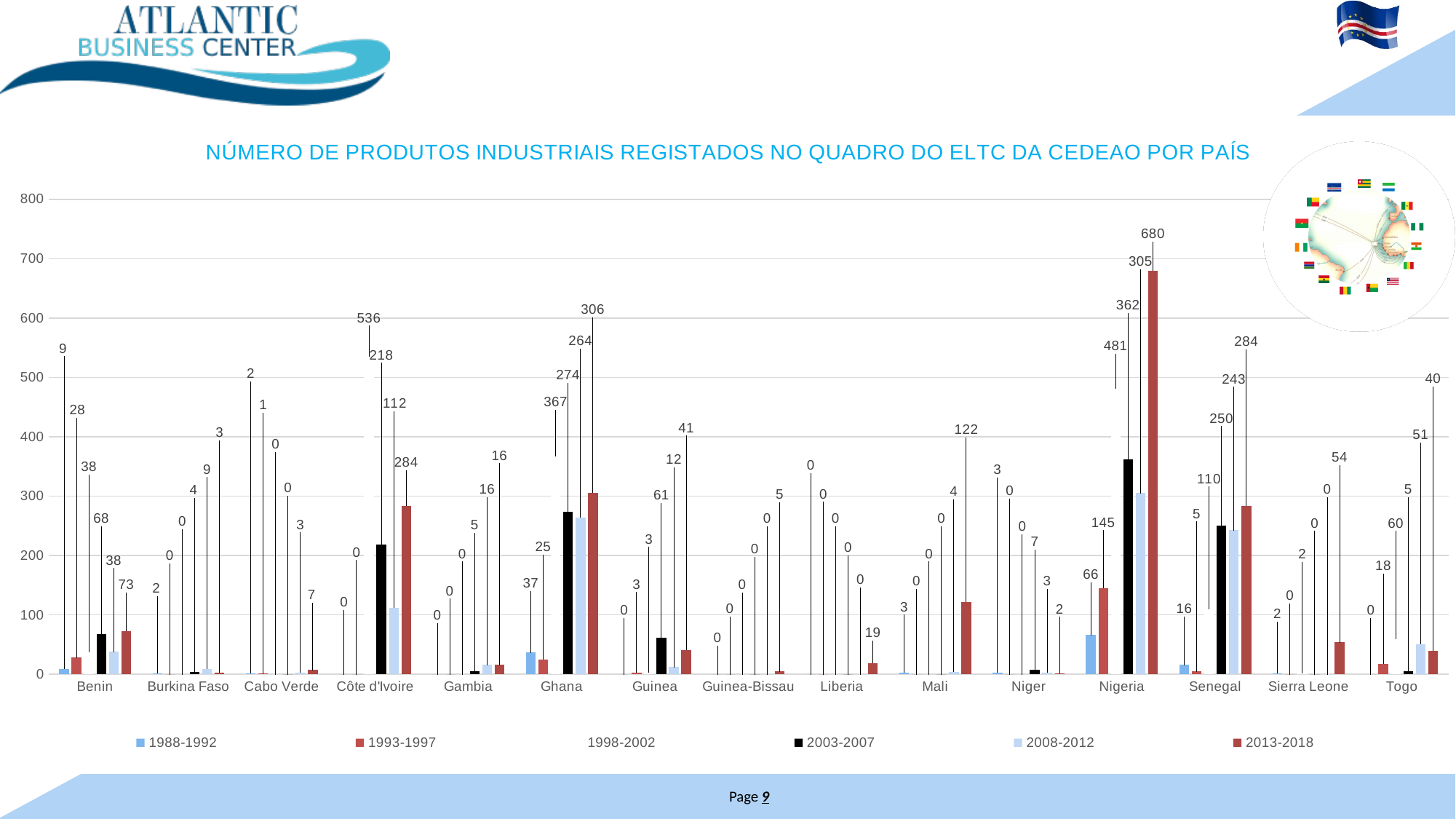
How many series does the legend list? 6 What is the value for Benin in the 2013-2018 series? 73 What kind of chart is shown on the slide? Bar chart What is the value for Mali in the 2013-2018 series? 122 What is the value for Nigeria in the 2013-2018 series? 680 What is the difference between the 2013-2018 values for Nigeria and Senegal? 396 Which country has the highest value in the 2013-2018 series? Nigeria What is the value for Ghana in the 2003-2007 series? 274 Is the value for Nigeria in the 2013-2018 series greater or less than 600? greater How many countries are shown on the x axis? 15 What is the value for Senegal in the 2013-2018 series? 284 Which is larger in the 2013-2018 series: Ghana or Senegal? Ghana